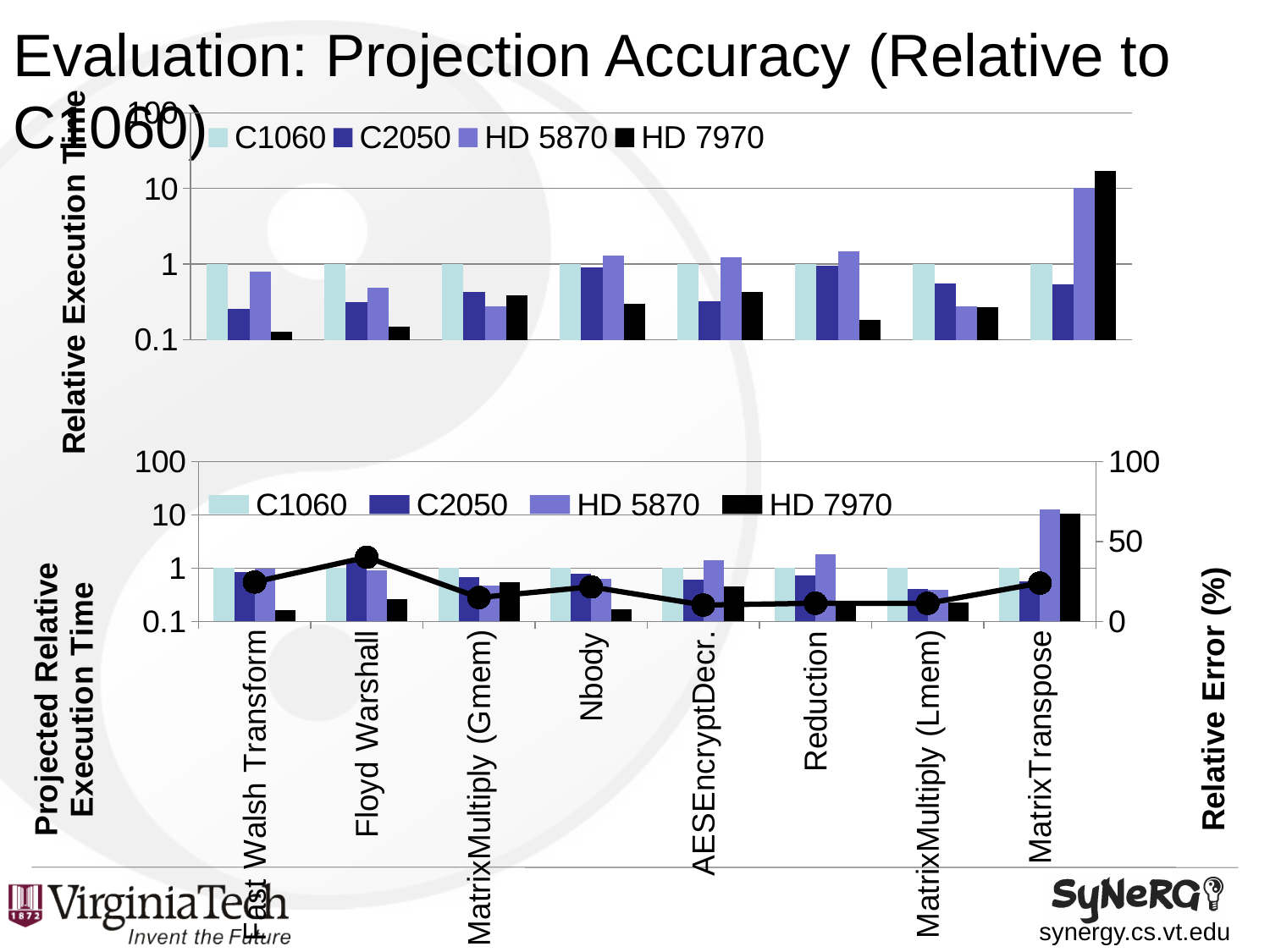
In the top chart, which series has the highest bar for MatrixTranspose? HD 7970 What is the label of the secondary (right-hand) y axis on the bottom chart? Relative Error (%) Which series is drawn in black in the legend of the bottom chart? HD 7970 In the bottom chart, is the Relative Error (%) for Floyd Warshall greater or less than 50? less In the top chart, which is larger for Reduction: the HD 5870 bar or the HD 7970 bar? HD 5870 How many benchmark categories are shown along the x axis of the bottom chart? 8 In the top chart, is the HD 5870 value for MatrixTranspose greater or less than 1? greater In the bottom chart, is the HD 7970 value for MatrixTranspose greater or less than 1? greater In the bottom chart, for which benchmark is the Relative Error (%) line at its highest point? Floyd Warshall How many series does the legend of the top chart list? 4 What type of chart is the top chart (Relative Execution Time)? bar chart